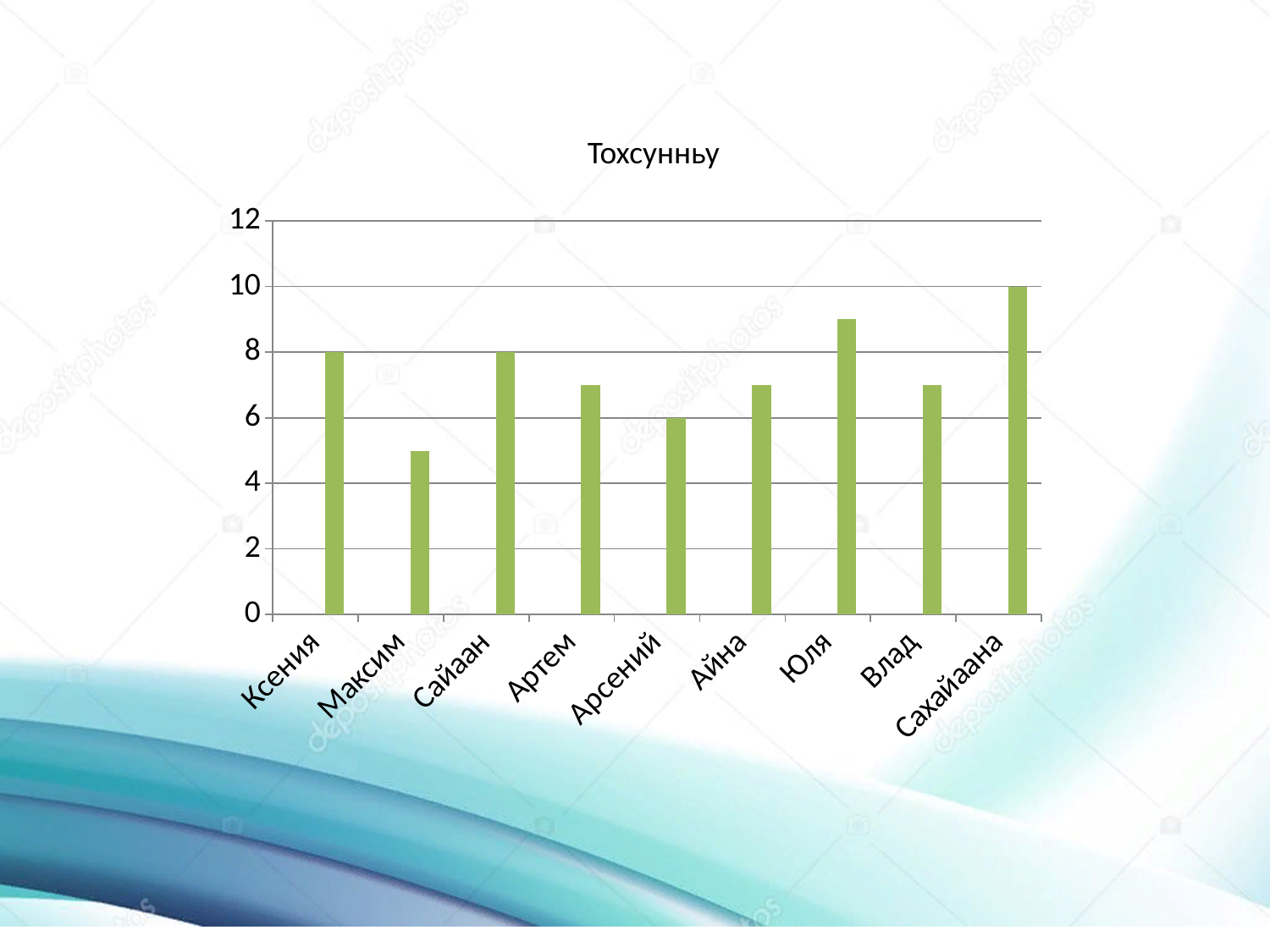
What is the value for Ксения? 8 How many categories are shown on the x axis of the chart? 9 What is the title of the chart? Тохсунньу What type of chart is shown on the slide? bar chart What is the value for Сахайаана? 10 Which category has the highest value? Сахайаана Which is larger, the value for Ксения or the value for Арсений? Ксения What is the value for Сайаан? 8 Is the value for Юля greater or less than 8? greater Which category has the lowest value? Максим Is the value for Максим greater or less than 6? less What is the value for Арсений? 6